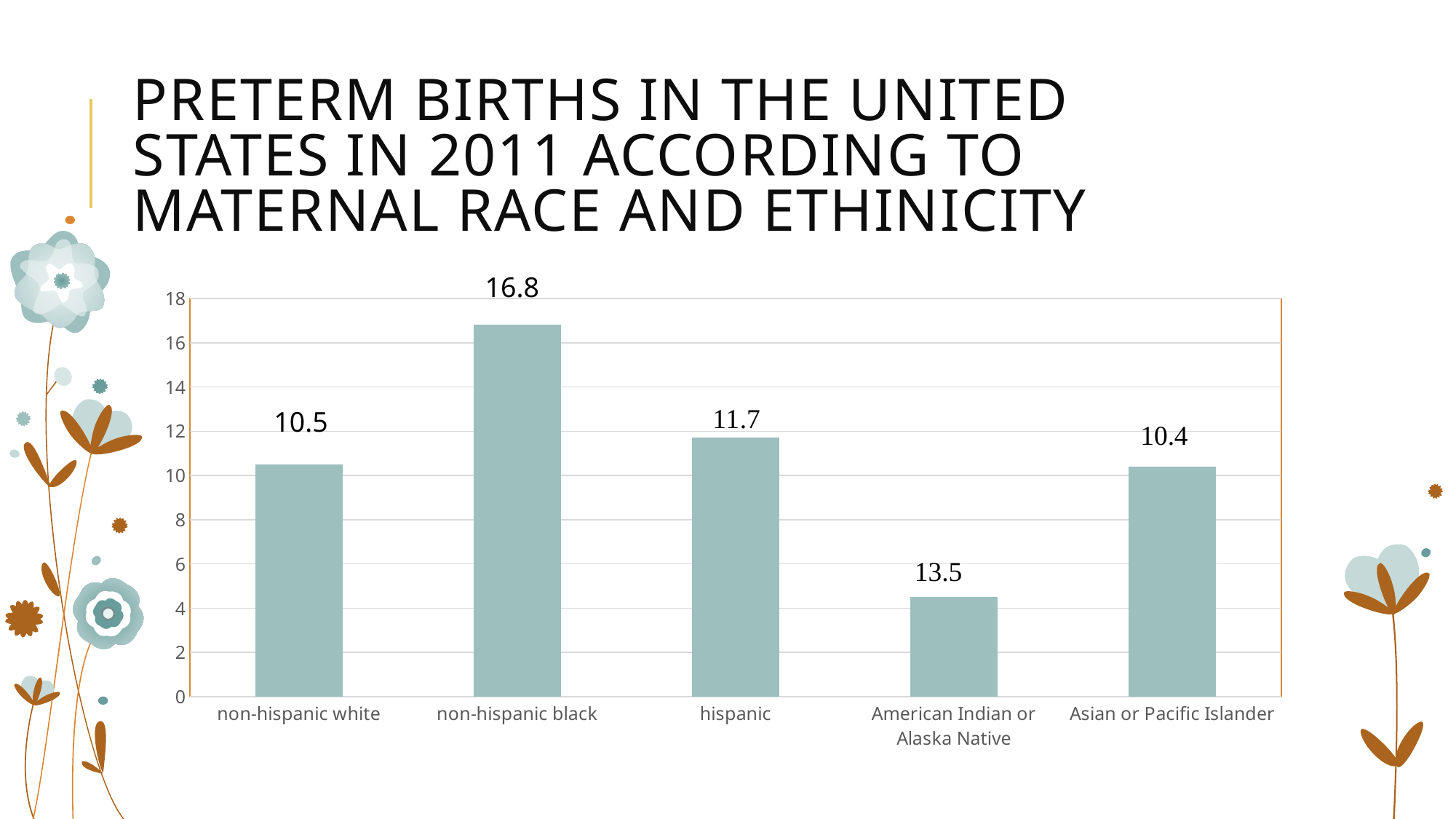
Is the value for non-hispanic black greater or less than 16? greater What kind of chart is shown on the slide? bar chart Which category has the highest value? non-hispanic black How many categories are shown on the x axis? 5 What year does the slide title say the preterm birth data is from? 2011 What is the data label shown for American Indian or Alaska Native? 13.5 What is the difference between the values for non-hispanic black and non-hispanic white? 6.3 What is the value for non-hispanic black? 16.8 What is the value for non-hispanic white? 10.5 What is the value for Asian or Pacific Islander? 10.4 What is the value for hispanic? 11.7 Which is larger, the value for hispanic or the value for non-hispanic white? hispanic